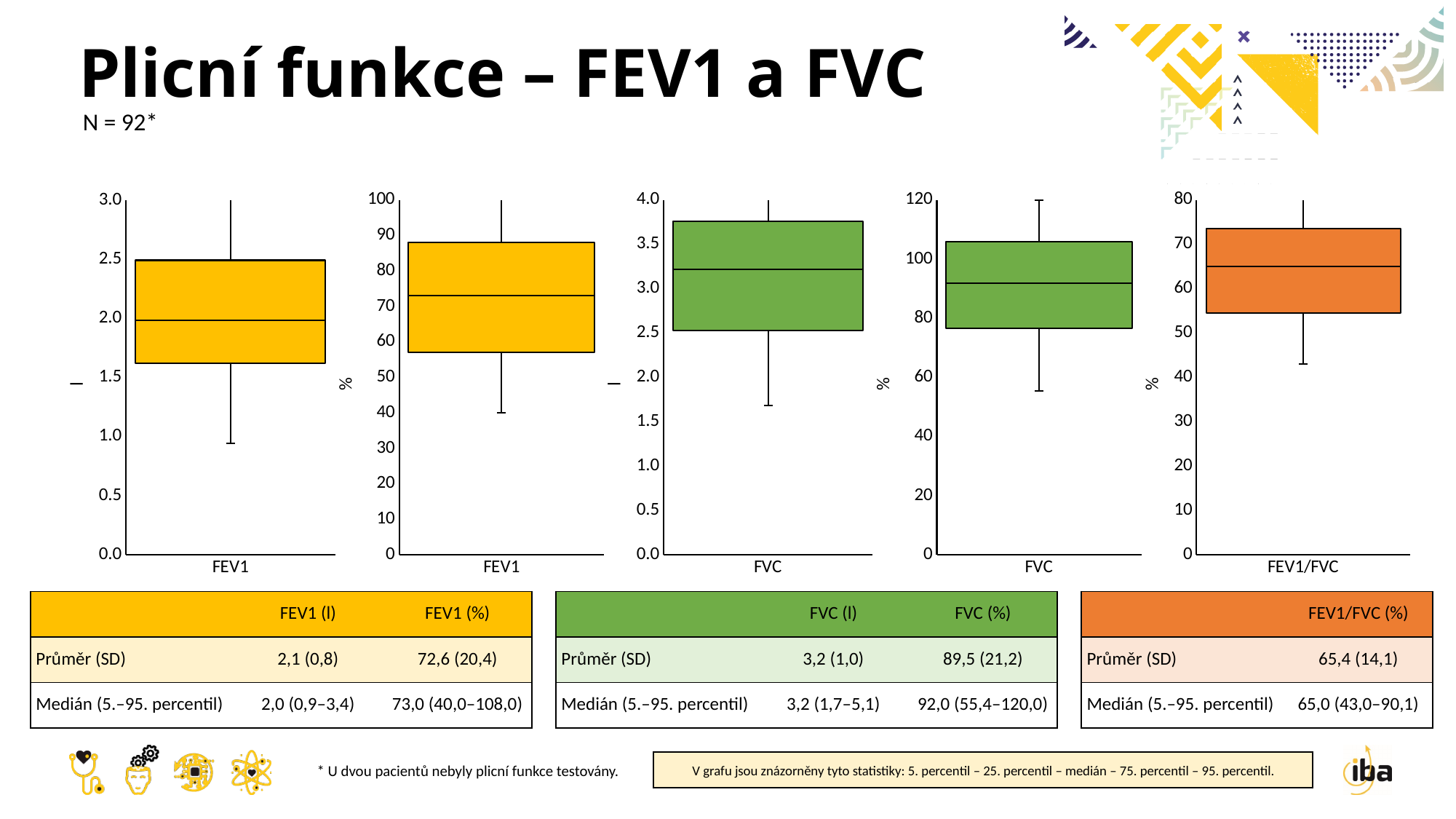
In the FEV1/FVC (%) box plot, is the median greater or less than 60? greater In the FEV1/FVC (%) box plot, what is the median value? 65,0 In the FEV1 (l) box plot, is the median greater or less than 1.5? greater In the FEV1 (l) box plot, what is the median value? 2,0 Which is larger: the median of FVC (%) or the median of FEV1 (%)? FVC (%) What colour are the boxes in the FVC box plots? green How many box plots are shown on the slide? 5 In the FEV1 (%) box plot, what is the median value? 73,0 In the FVC (%) box plot, what is the median value? 92,0 What kind of chart is used to show FEV1 and FVC on this slide? box plot In the FVC (l) box plot, what is the median value? 3,2 In the FVC (%) box plot, is the lower whisker end (5th percentile) greater or less than 60? less